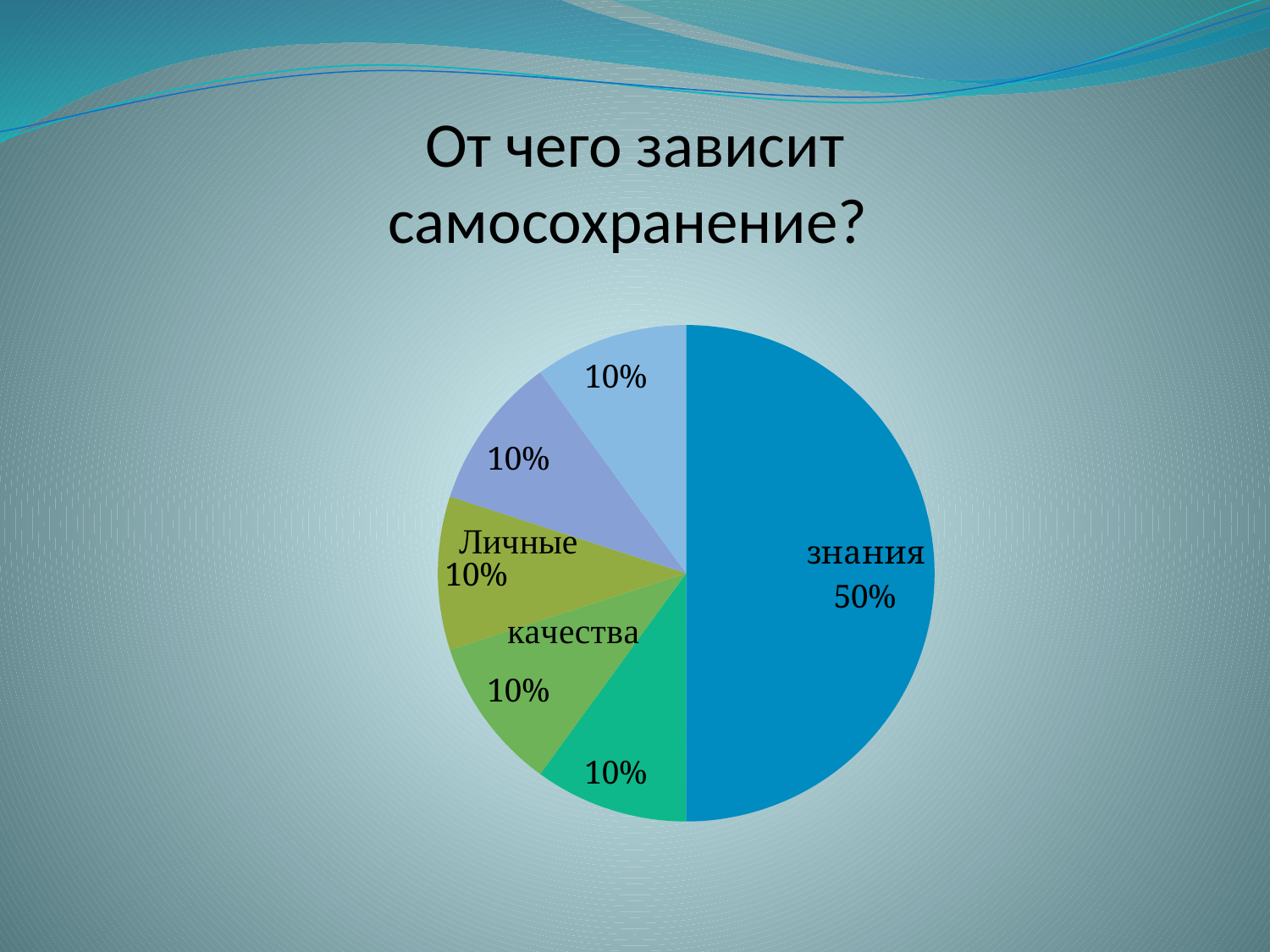
How many slices does the pie chart have? 6 How many slices of the pie chart are labelled 10%? 5 What is the title of the chart on the slide? От чего зависит самосохранение? Is the share of the 'знания' slice greater or less than 40%? greater What is the combined share of all the slices labelled 10%? 50% What is the difference between the 'знания' slice and the 'Личные качества' slice? 40% Which is larger, the 'знания' slice or the 'Личные качества' slice? знания What share of the pie does the 'знания' slice take? 50% What kind of chart is shown on the slide? pie chart Which slice of the pie chart is the largest? знания What value is shown for the slice labelled 'Личные качества'? 10% What value is shown for the 'знания' slice? 50%